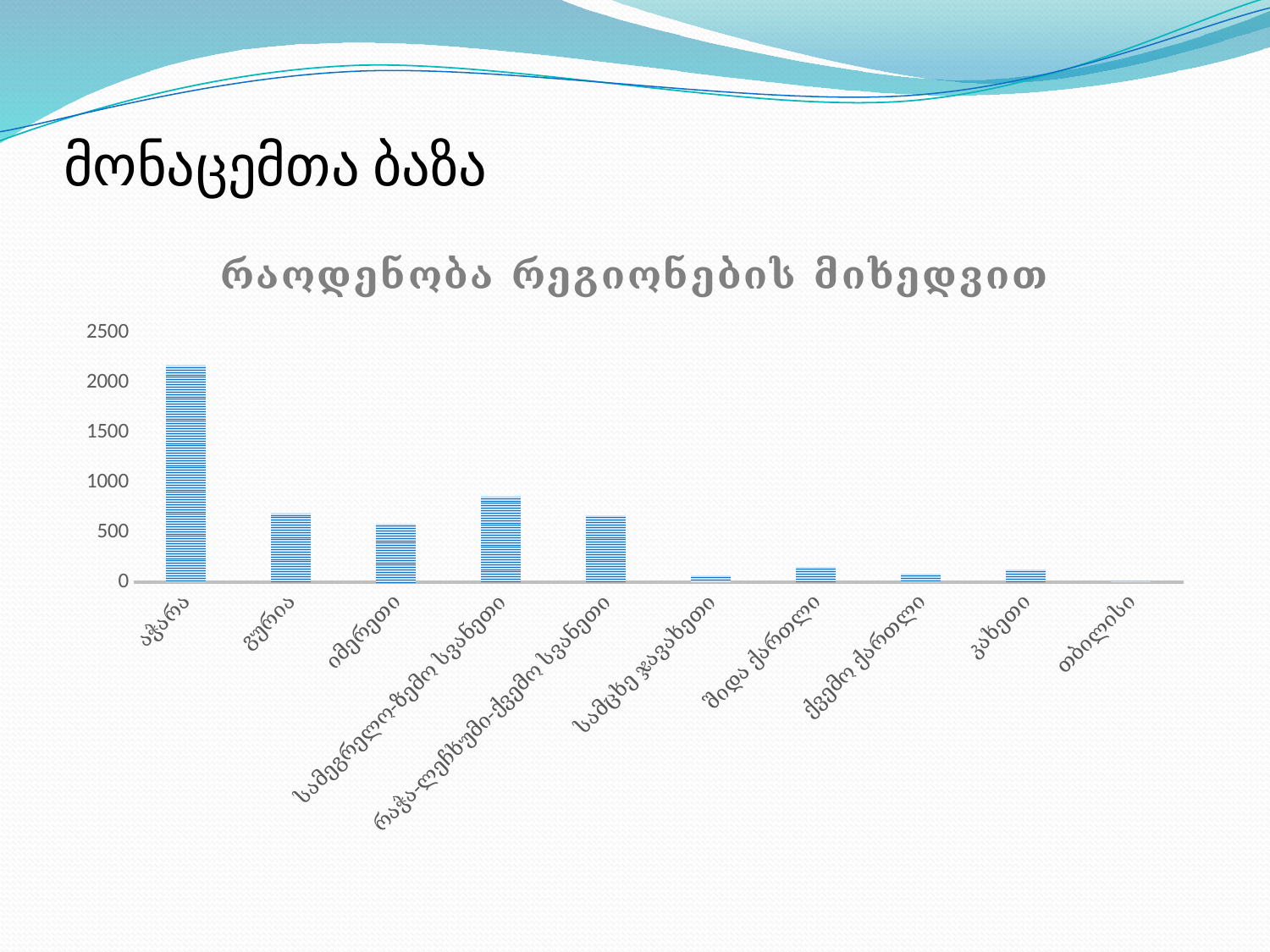
How many regions (categories) are shown on the x axis of the chart? 10 Is the value for აჭარა greater or less than 2000? greater Which is larger, the value for სამეგრელო-ზემო სვანეთი or the value for იმერეთი? სამეგრელო-ზემო სვანეთი Is the value for შიდა ქართლი greater or less than 500? less Is the value for გურია greater or less than 500? greater What is the highest value shown on the vertical axis of the chart? 2500 What kind of chart is shown on the slide? bar chart Which is larger, the value for აჭარა or the value for გურია? აჭარა Which region has the highest value in the chart? აჭარა What is the title of the chart? რაოდენობა რეგიონების მიხედვით